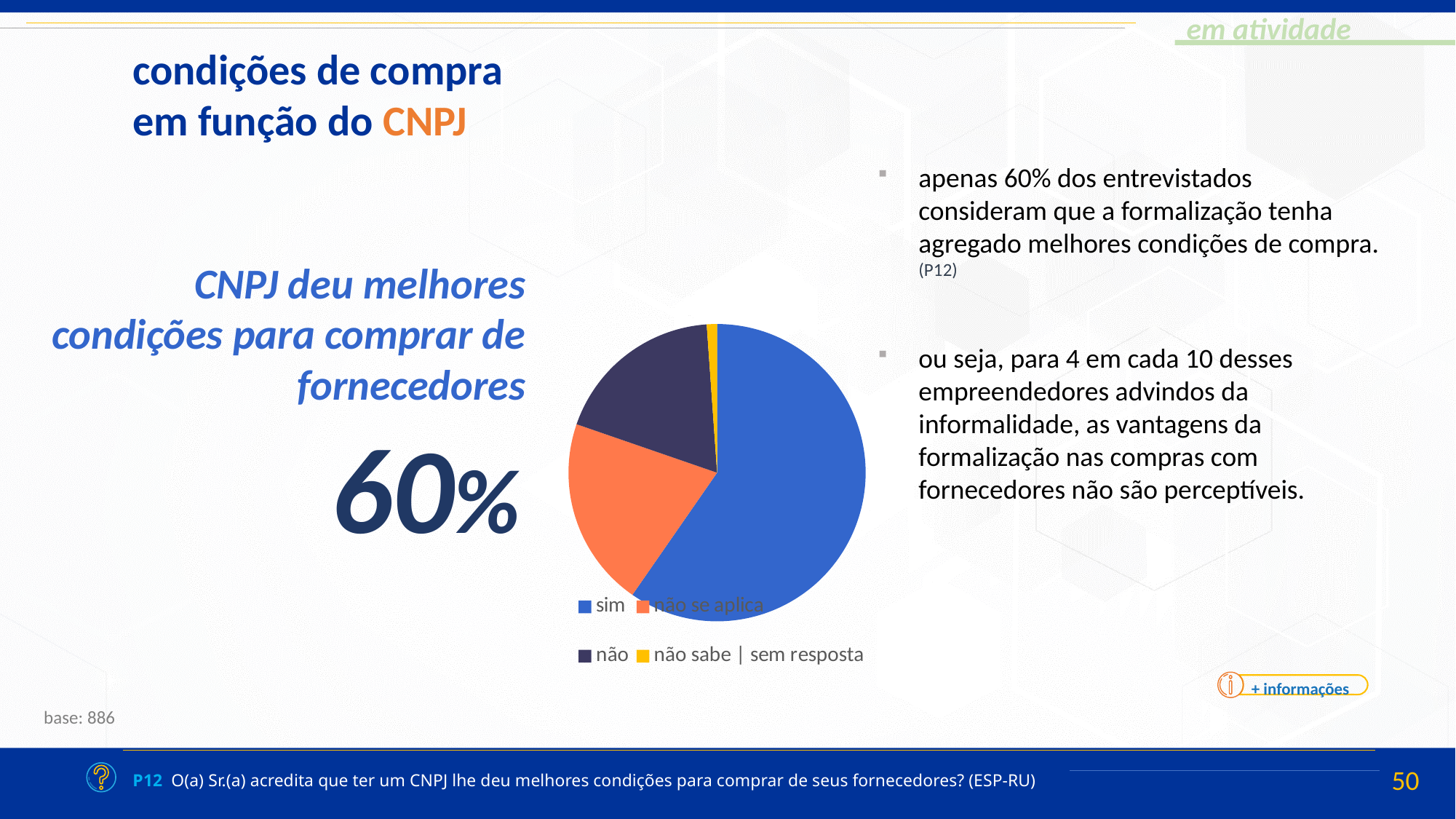
What is the base (number of respondents) stated for the chart? 886 Which category has the largest slice in the pie chart? sim How many entries does the legend of the pie chart list? 4 Which category has the smallest slice in the pie chart? não sabe | sem resposta What kind of chart is shown on the slide? pie chart Is the share for "sim" in the pie chart greater or less than 50%? greater Which slice is larger in the pie chart, "não se aplica" or "não"? não se aplica What colour is the "sim" slice in the pie chart? blue How many slices does the pie chart have? 4 What share of respondents answered "sim" in the pie chart? 60% Which slice is larger in the pie chart, "sim" or "não se aplica"? sim